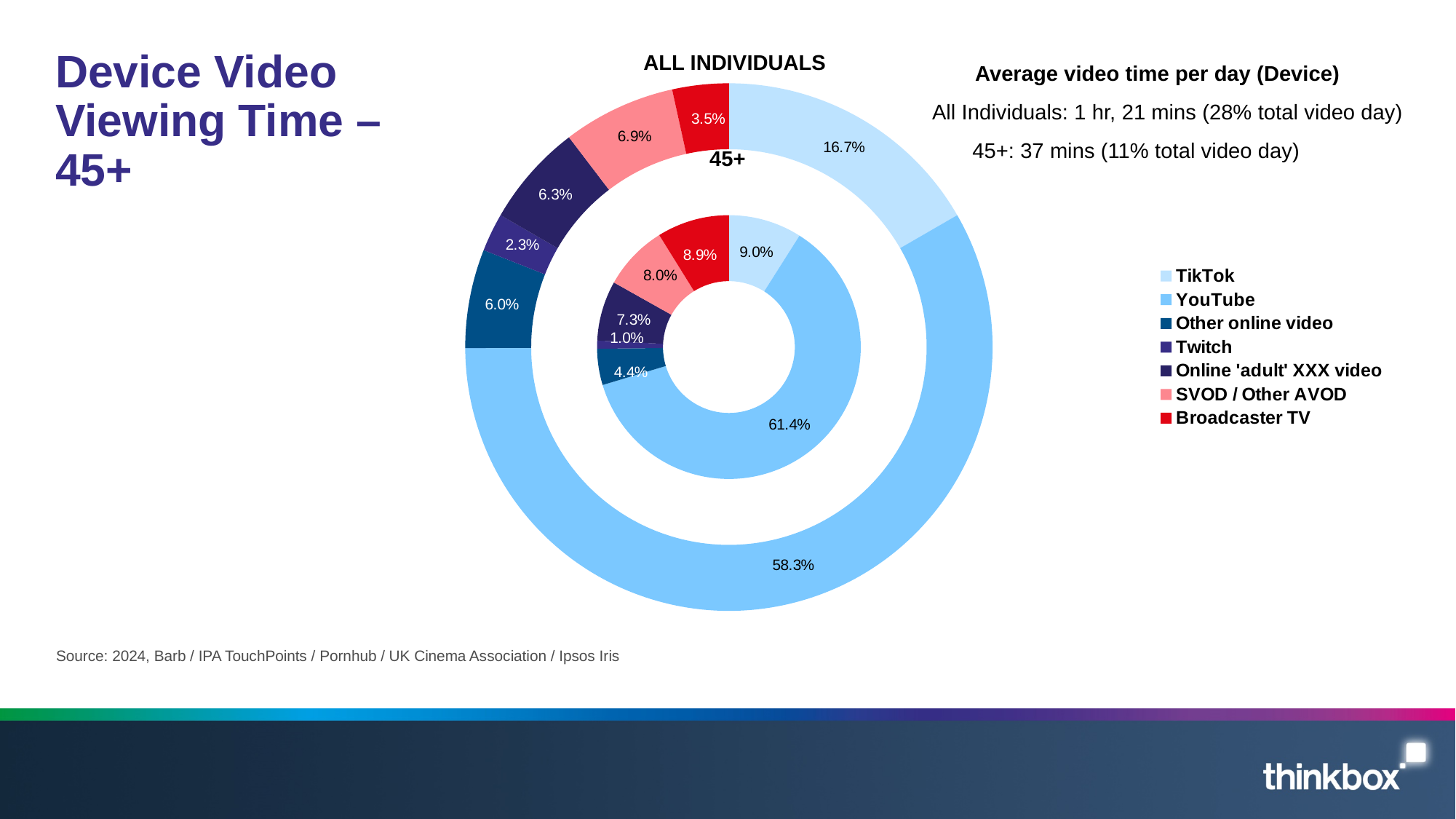
What kind of chart is shown on the slide? Doughnut chart How many categories does the legend list? 7 What is the Broadcaster TV share for All Individuals? 3.5% What is the Twitch share for All Individuals? 2.3% What is the SVOD / Other AVOD share for 45+? 8.0% Is the Broadcaster TV share larger for All Individuals or for 45+? 45+ What is the YouTube share in the inner ring (45+)? 61.4% Which category has the smallest share in the 45+ ring? Twitch What is the difference between the TikTok share for All Individuals and for 45+? 7.7% Which category has the largest share in the All Individuals ring? YouTube What is the TikTok share for 45+? 9.0% What is the YouTube share in the outer ring (All Individuals)? 58.3%